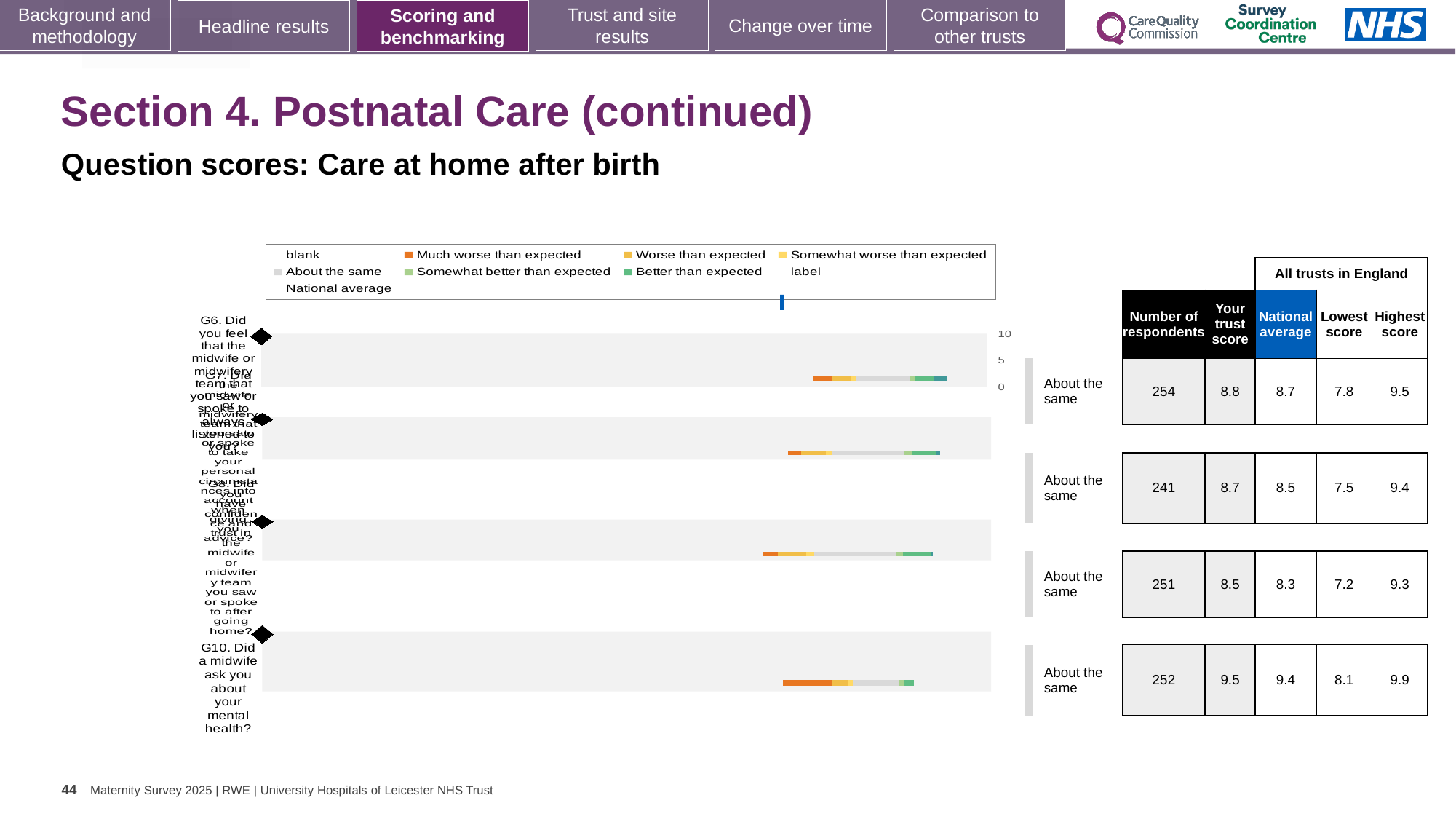
Which question row has the highest trust score? G10 (9.5) How many question bars are plotted in the chart? 4 What is the highest score among all trusts in England for G10 (Did a midwife ask you about your mental health?)? 9.9 Which legend entry is shown in light grey? About the same Which legend entry is shown in orange? Much worse than expected What is the trust score for G10 (Did a midwife ask you about your mental health?)? 9.5 What is the national average for G10 (Did a midwife ask you about your mental health?)? 9.4 For G10, what is the difference between the highest score (9.9) and the lowest score (8.1)? 1.8 What is the number of respondents for G10 (Did a midwife ask you about your mental health?)? 252 What is the number of respondents for the top question row (G6)? 254 What kind of chart is used to show the question scores on this slide? bar chart For G10, which is larger: the trust score or the national average? the trust score (9.5)